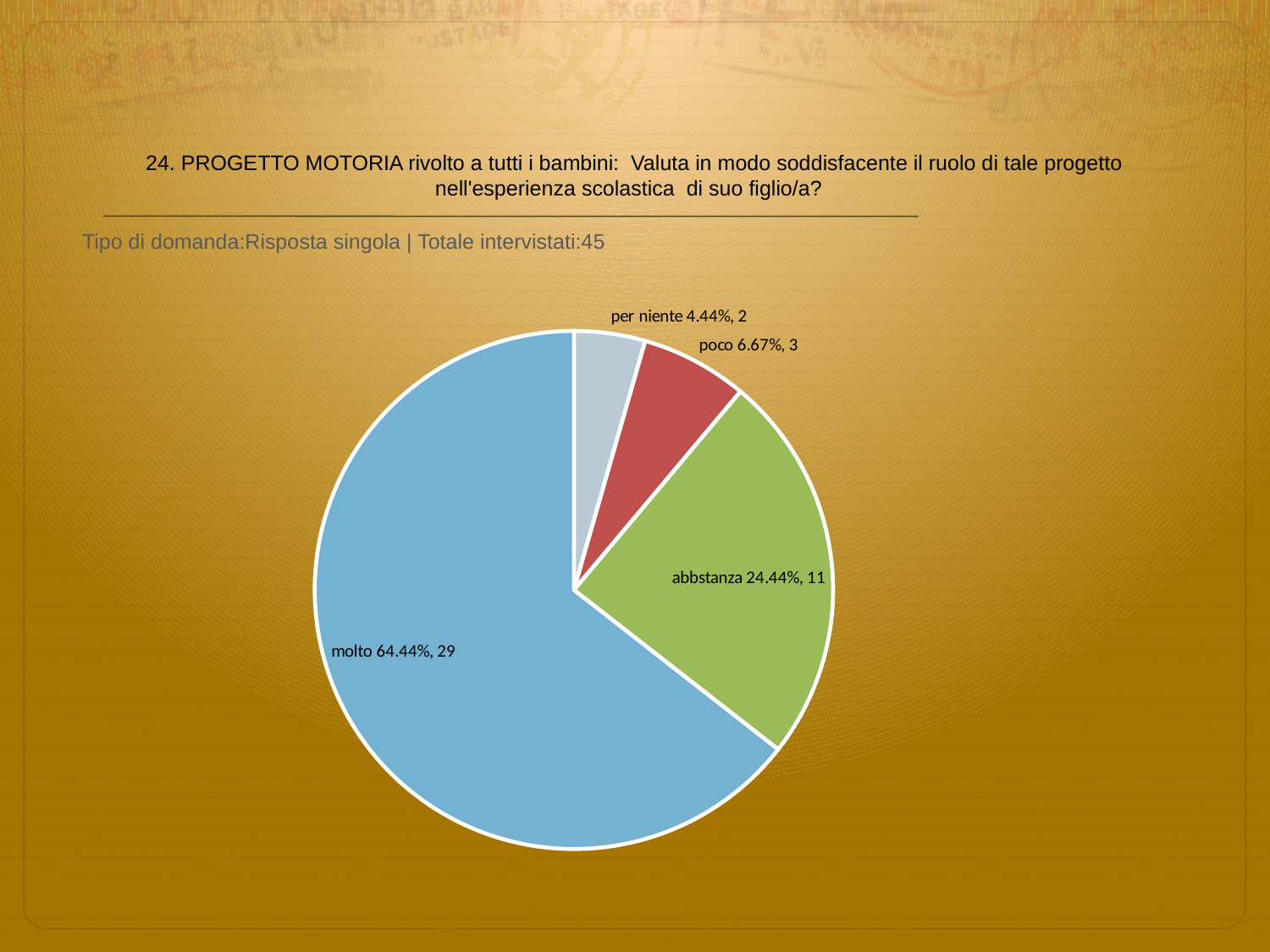
How many respondents answered 'abbstanza'? 11 Which category has the largest slice? molto Which category has the smallest slice? per niente What percentage share does the 'molto' slice have? 64.44% What is the total number of respondents across all slices? 45 How many slices does the pie chart have? 4 What percentage share does the 'per niente' slice have? 4.44% What is the difference in respondent count between 'molto' and 'abbstanza'? 18 How many respondents answered 'poco'? 3 Which has more respondents, 'poco' or 'per niente'? poco What colour is the 'abbstanza' slice? green What kind of chart is shown on the slide? pie chart